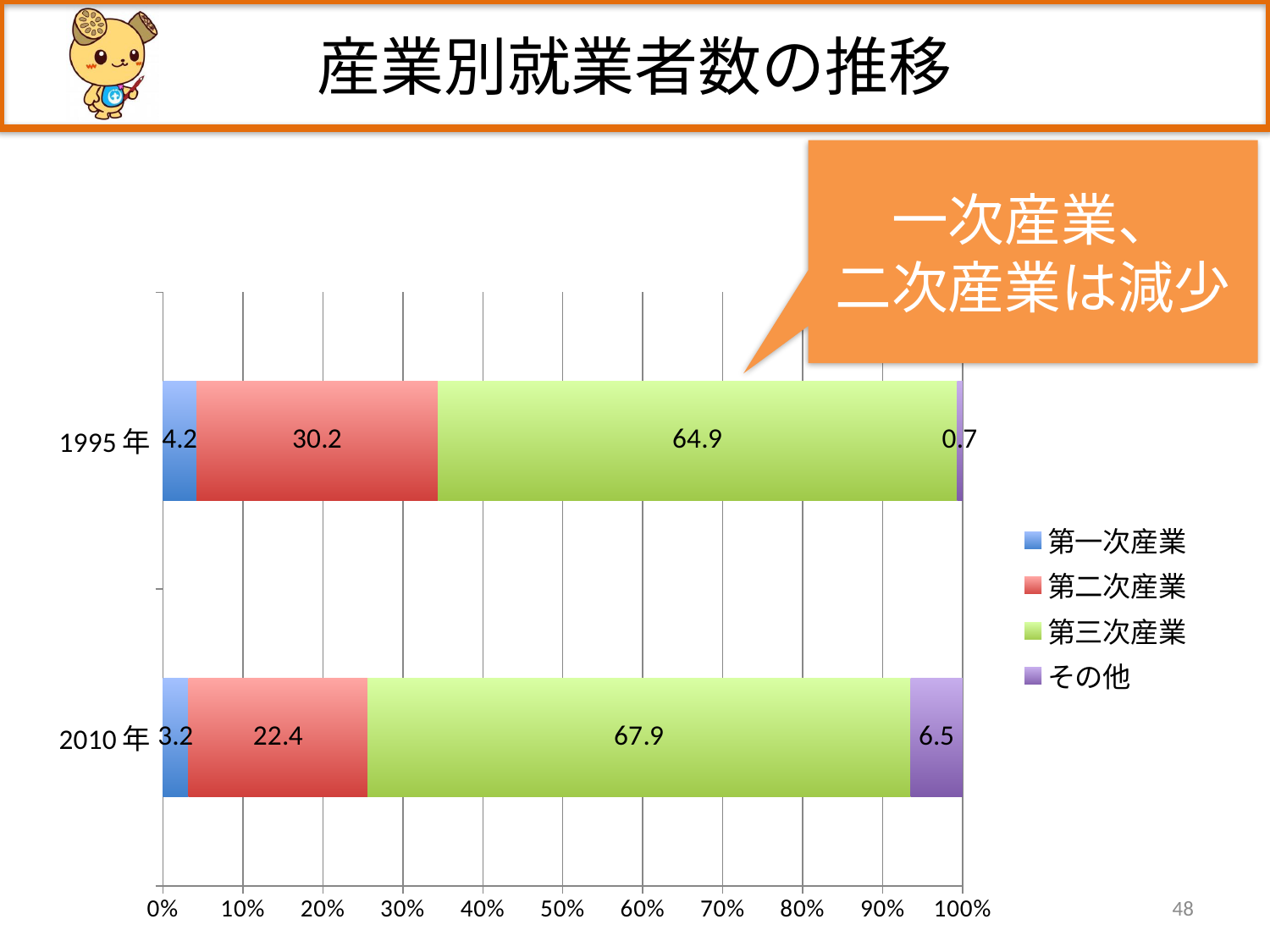
What is the title of the chart on the slide? 産業別就業者数の推移 Which is larger, the 第一次産業 value for 1995年 or for 2010年? 1995年 What is the value for 第三次産業 in 2010年? 67.9 What is the value for その他 in 1995年? 0.7 What is the value for 第一次産業 in 2010年? 3.2 What is the difference between the 第二次産業 values for 1995年 and 2010年? 7.8 What kind of chart is shown on the slide? Stacked bar chart How many categories (years) are shown on the chart? 2 What is the value for 第二次産業 in 1995年? 30.2 Which series has the smallest value in the 1995年 bar? その他 Which series has the largest value in the 2010年 bar? 第三次産業 How many series does the legend list? 4